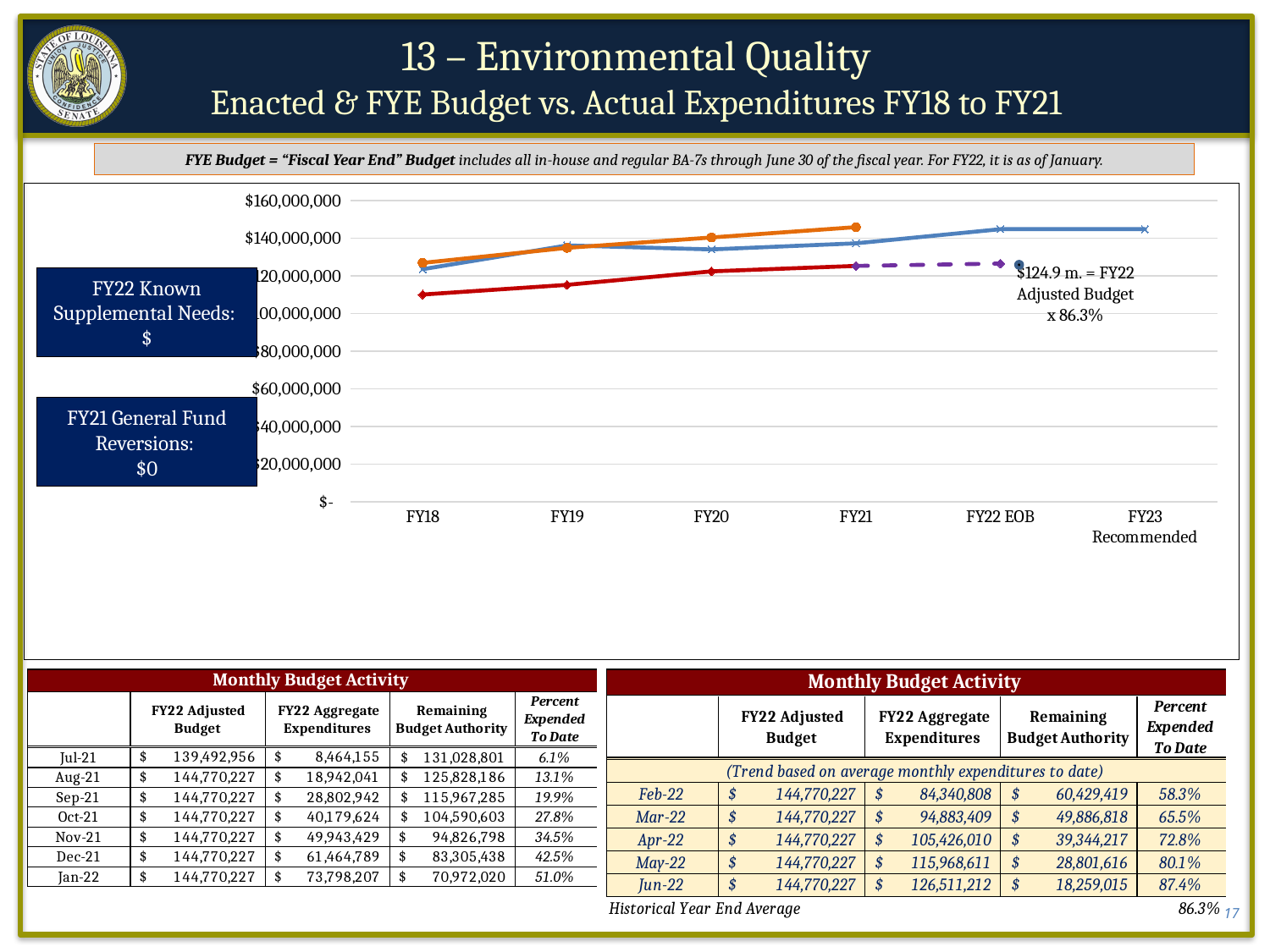
How many fiscal-year categories are shown along the x axis of the chart? 6 At FY18, which line is higher on the chart, the orange line or the red line? orange line Does the orange line rise or fall from FY18 to FY21? rise Is the value of the red line at FY19 greater or less than $120,000,000? less Is the value of the orange line at FY21 greater or less than $140,000,000? greater Does the red line rise or fall from FY18 to FY21? rise Is the value of the orange line at FY18 greater or less than $120,000,000? greater What is the last category label on the chart's x axis? FY23 Recommended What kind of chart is shown on the slide? line chart What is the highest value shown on the chart's y axis? $160,000,000